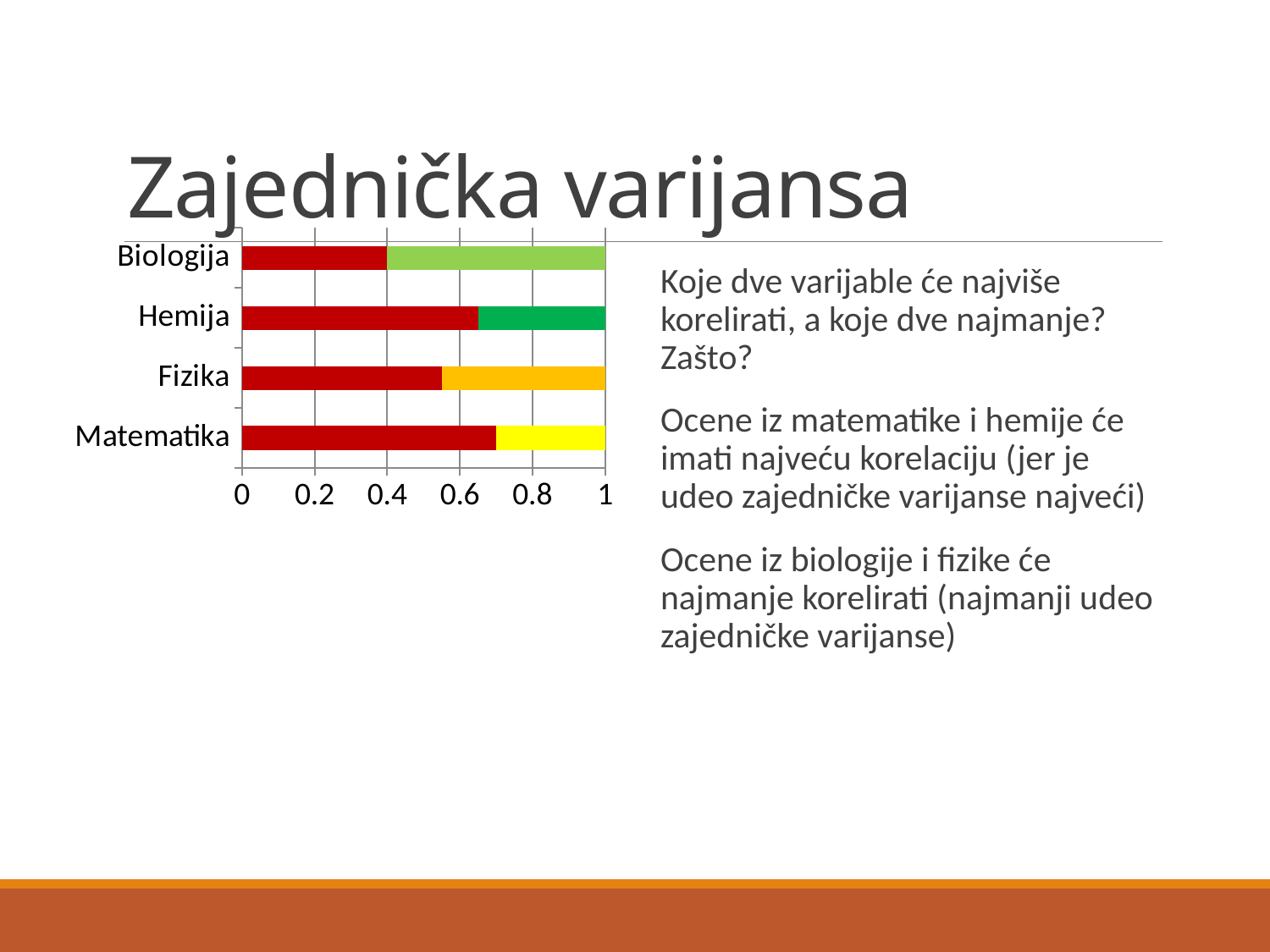
Is the red segment for Hemija greater or less than 0.6? greater Is the red segment for Matematika greater or less than 0.6? greater How many categories are shown on the chart? 4 Which category has the shortest red segment? Biologija Is the red segment for Fizika greater or less than 0.6? less What is the title of the slide containing the chart? Zajednička varijansa Which category has the longest red segment? Matematika What colour is the second segment of the Matematika bar? yellow What kind of chart is shown on the slide? bar chart What is the total length of the stacked bar for Hemija? 1 Which has the longer red segment, Hemija or Fizika? Hemija What is the value of the red segment for Biologija? 0.4